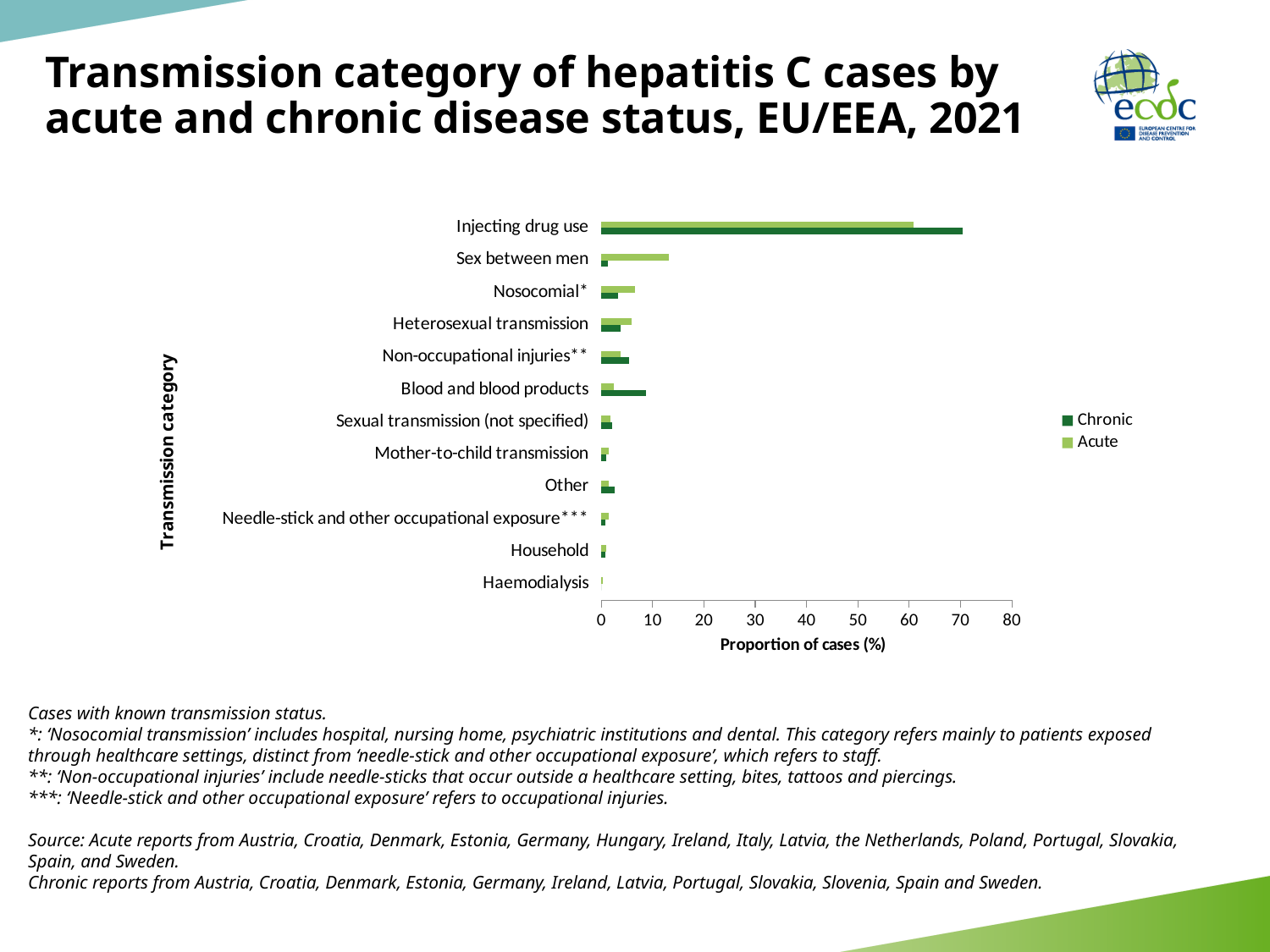
For Sex between men, which series has the larger value, Chronic or Acute? Acute Which transmission category has the highest proportion of chronic cases? Injecting drug use How many transmission categories are plotted on the chart? 12 For Injecting drug use, which series has the larger value, Chronic or Acute? Chronic How many series does the legend list? 2 Is the acute value for Sex between men greater or less than 10? greater Which transmission category has the highest proportion of acute cases? Injecting drug use Is the chronic value for Injecting drug use greater or less than 60? greater Which transmission category has the lowest proportion of cases for both series? Haemodialysis Is the acute value for Injecting drug use greater or less than 50? greater What is the title of the x axis? Proportion of cases (%) What kind of chart is shown on the slide? Bar chart